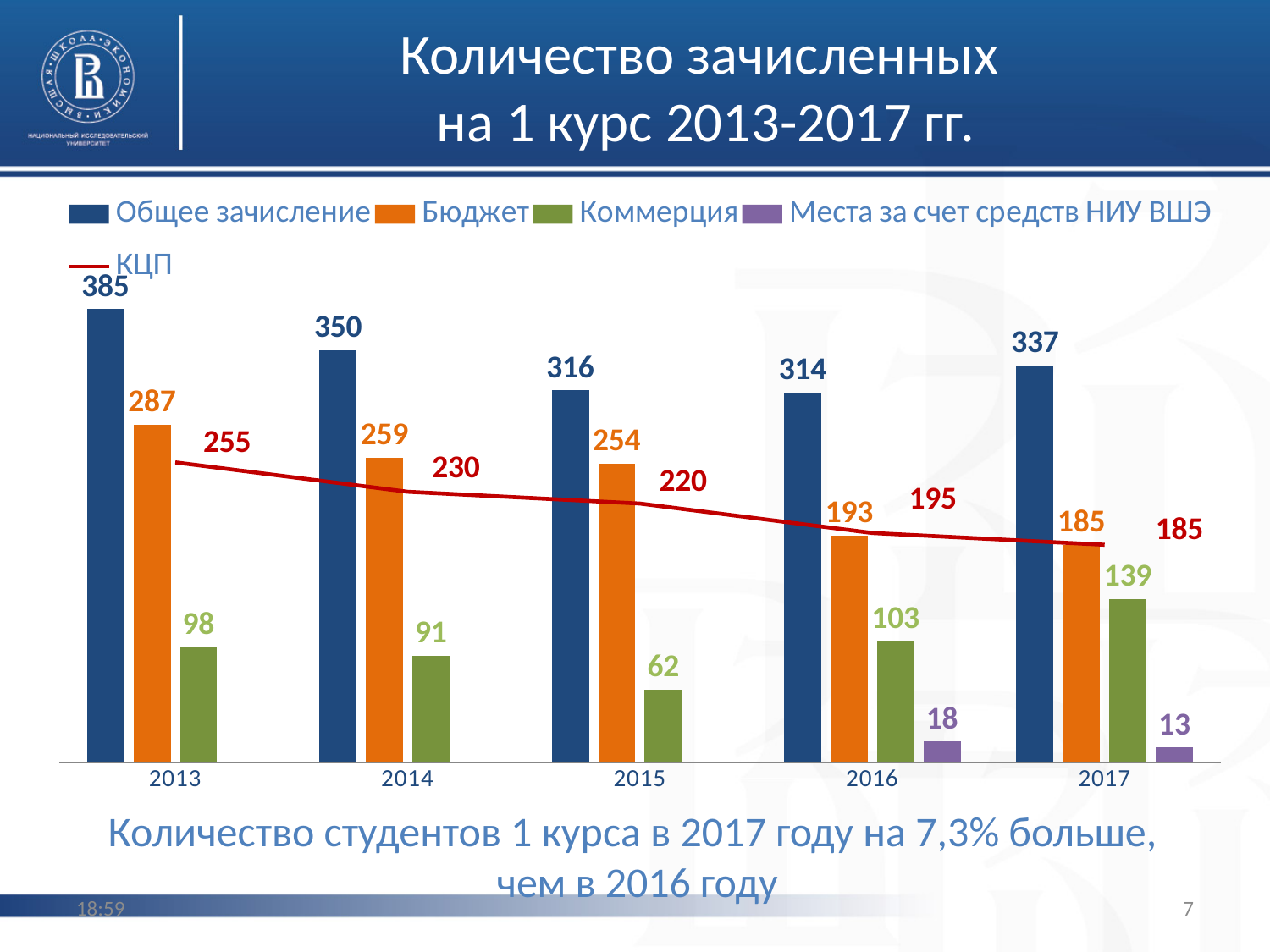
How many years are shown on the x axis? 5 What is the value of Бюджет for 2016? 193 What kind of chart is shown on the slide? Combined bar and line chart In which year is Общее зачисление lowest? 2016 What is the value of Общее зачисление for 2013? 385 How many series does the legend list? 5 Does the КЦП line rise or fall from 2013 to 2017? Falls What is the value of Места за счет средств НИУ ВШЭ for 2017? 13 What is the difference between Общее зачисление in 2017 and in 2016? 23 What is the value of КЦП for 2015? 220 In which year is Коммерция highest? 2017 Which is larger: Бюджет in 2014 or Бюджет in 2015? Бюджет in 2014